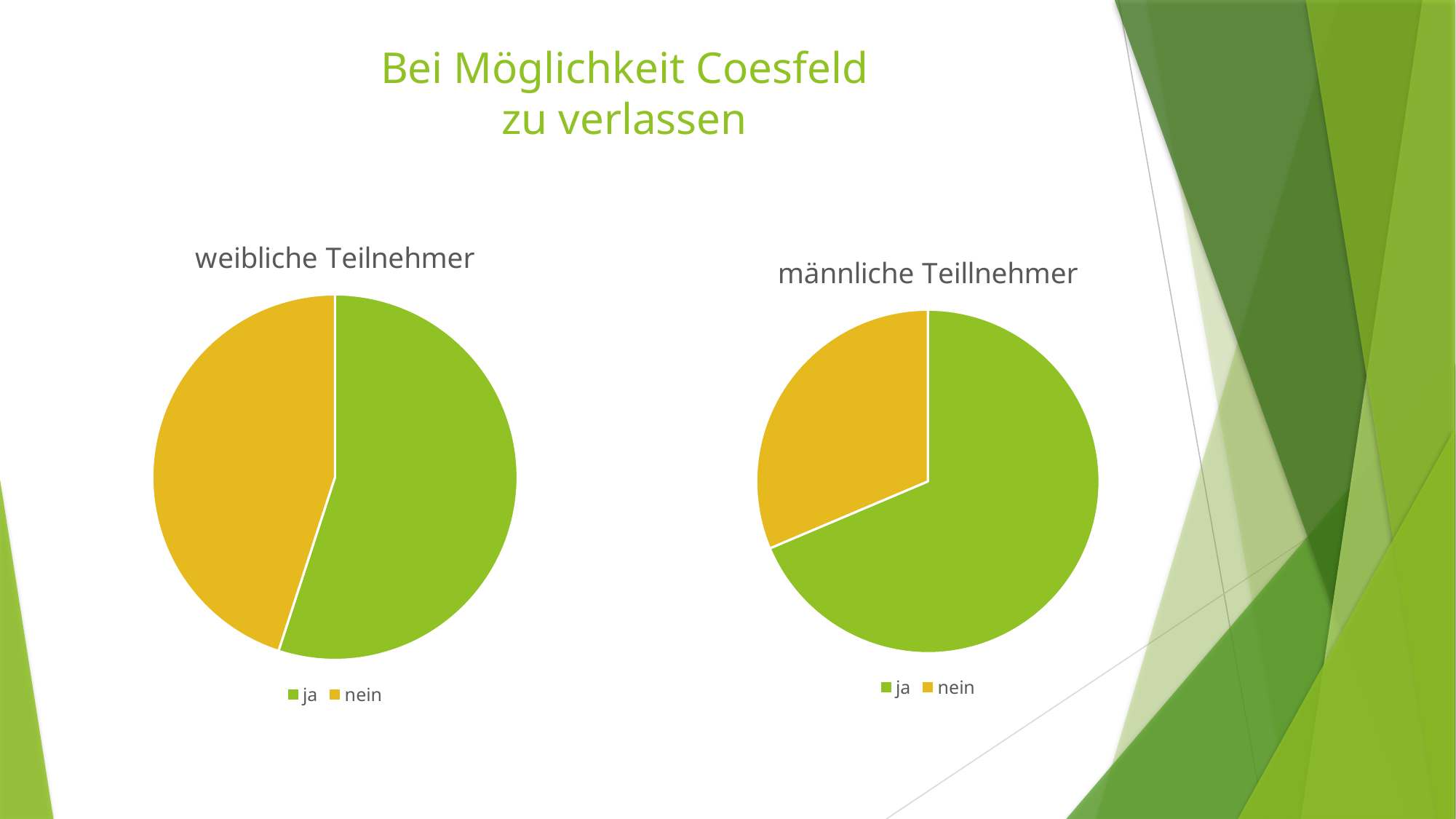
What is the title of the slide containing the two pie charts? Bei Möglichkeit Coesfeld zu verlassen In the "weibliche Teilnehmer" chart, which slice is larger, "ja" or "nein"? ja Which chart has the larger "nein" share, "weibliche Teilnehmer" or "männliche Teillnehmer"? weibliche Teilnehmer In the "männliche Teillnehmer" chart, which slice is the smallest? nein What kind of chart is the "männliche Teillnehmer" chart? pie chart What kind of chart is the "weibliche Teilnehmer" chart? pie chart In the "weibliche Teilnehmer" chart, what colour represents "nein"? yellow How many slices does the "weibliche Teilnehmer" pie chart have? 2 In the "männliche Teillnehmer" chart, which slice is larger, "ja" or "nein"? ja How many entries does the legend of the "männliche Teillnehmer" chart list? 2 In the "männliche Teillnehmer" chart, which slice is the largest? ja How many slices does the "männliche Teillnehmer" pie chart have? 2